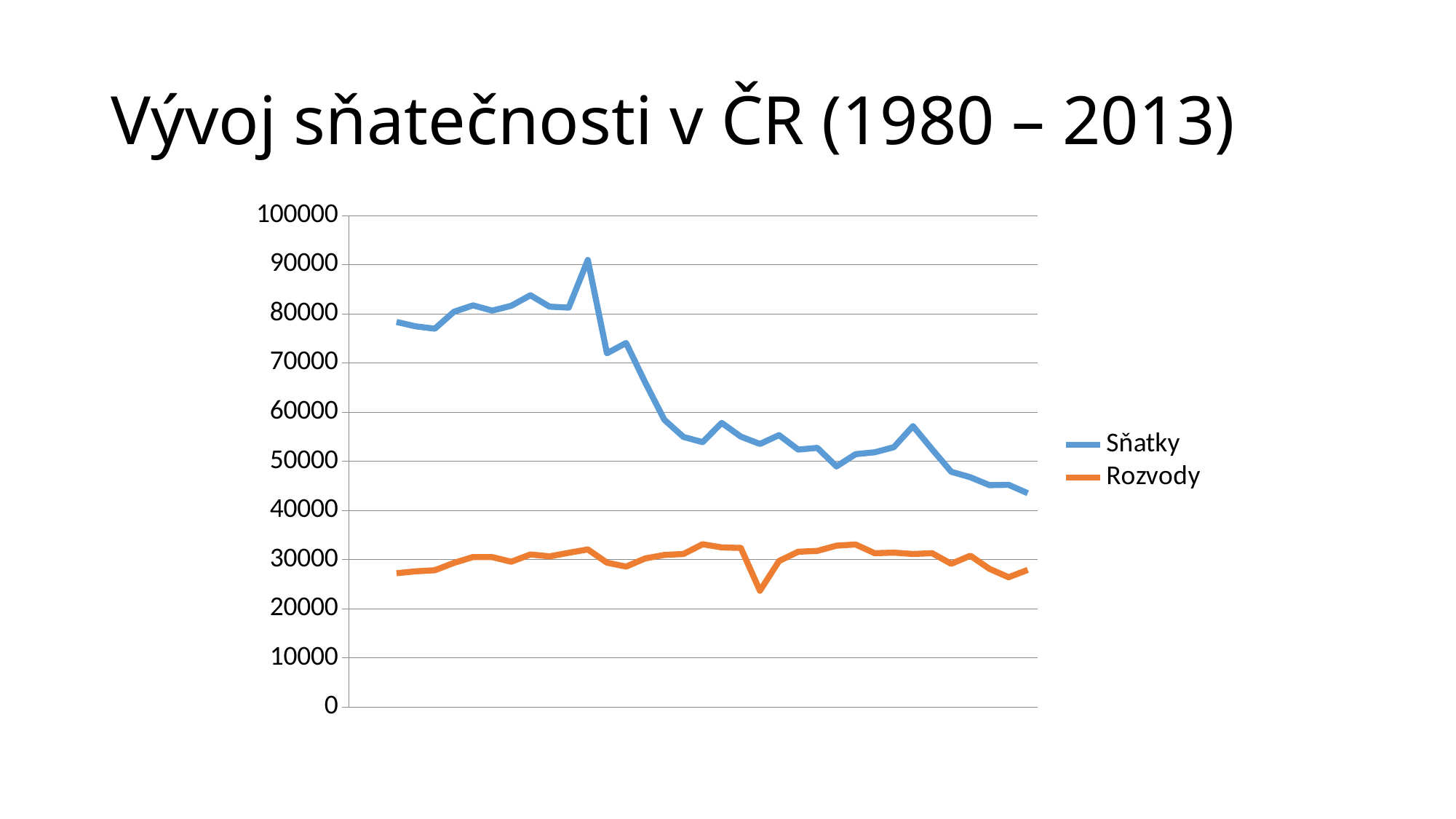
What is the title of the slide containing the chart? Vývoj sňatečnosti v ČR (1980 – 2013) Is the lowest value of the Rozvody series greater or less than 25000? less What kind of chart is shown on the slide? line chart What are the two series named in the legend? Sňatky and Rozvody Is the highest value of the Sňatky series greater or less than 80000? greater How many series does the legend list? 2 Is the last value of the Sňatky series greater or less than 50000? less Overall, do the values of the Sňatky series rise or fall from left to right? fall Which series reaches the highest value on the chart? Sňatky Which series has the higher values across the whole chart, Sňatky or Rozvody? Sňatky